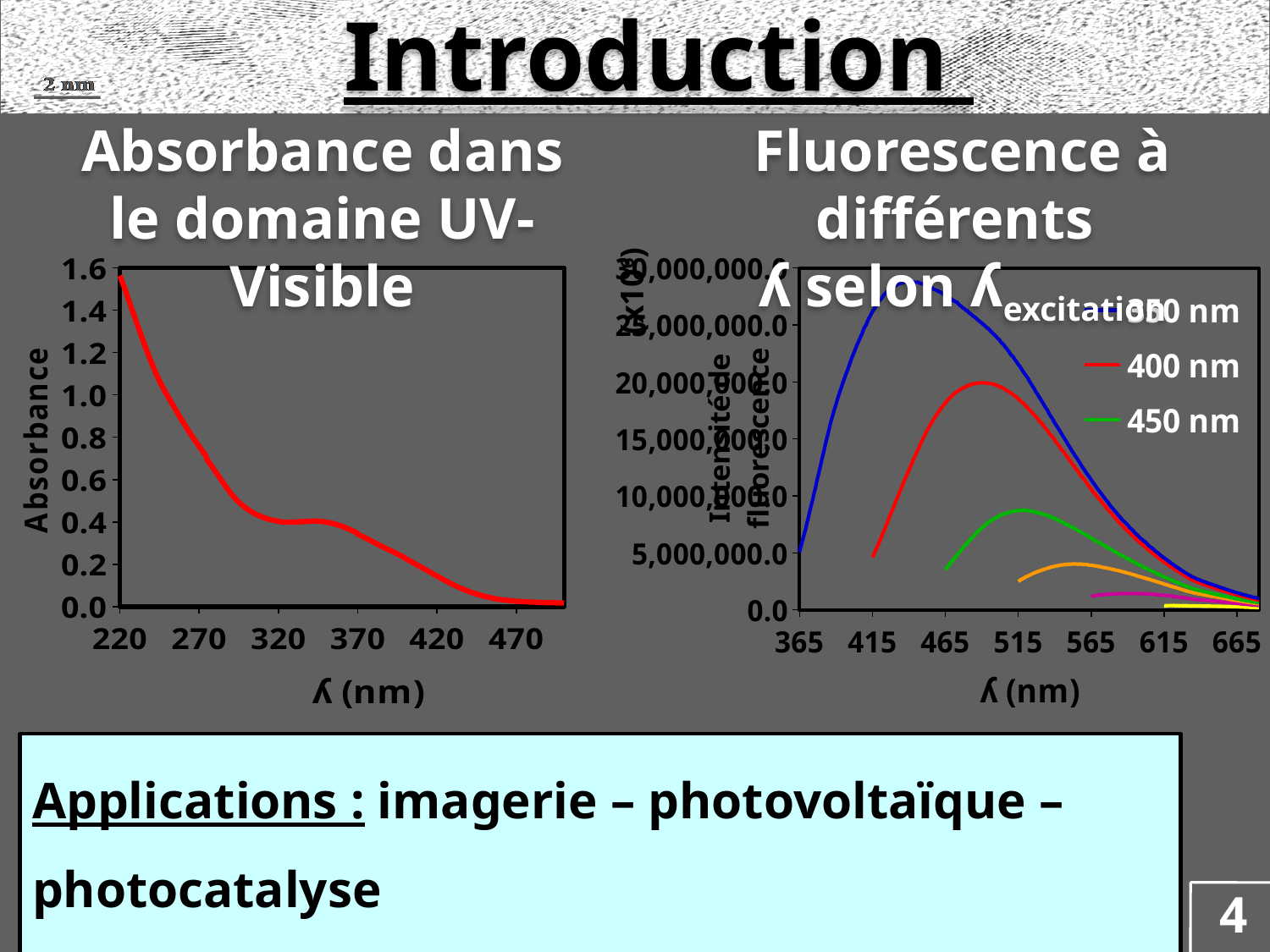
What kind of chart is the right chart, 'Fluorescence à différents λ selon λexcitation'? line chart In the right chart 'Fluorescence à différents λ selon λexcitation', which of the 400 nm and 450 nm series reaches a higher peak intensity? 400 nm In the right chart 'Fluorescence à différents λ selon λexcitation', what colour is the 400 nm series line? red In the right chart 'Fluorescence à différents λ selon λexcitation', which excitation wavelength series reaches the highest fluorescence intensity? 350 nm In the left chart 'Absorbance dans le domaine UV-Visible', is the absorbance at 220 nm greater or less than 1.4? greater What is the y-axis label of the left chart 'Absorbance dans le domaine UV-Visible'? Absorbance In the left chart 'Absorbance dans le domaine UV-Visible', does the absorbance rise or fall as the wavelength increases from 220 nm to 470 nm? fall In the right chart 'Fluorescence à différents λ selon λexcitation', is the peak intensity of the 350 nm series greater or less than 25,000,000.0? greater In the right chart 'Fluorescence à différents λ selon λexcitation', is the peak intensity of the 450 nm series greater or less than 10,000,000.0? less In the right chart 'Fluorescence à différents λ selon λexcitation', does the 350 nm series rise or fall between 515 nm and 665 nm? fall What kind of chart is the left chart, 'Absorbance dans le domaine UV-Visible'? line chart